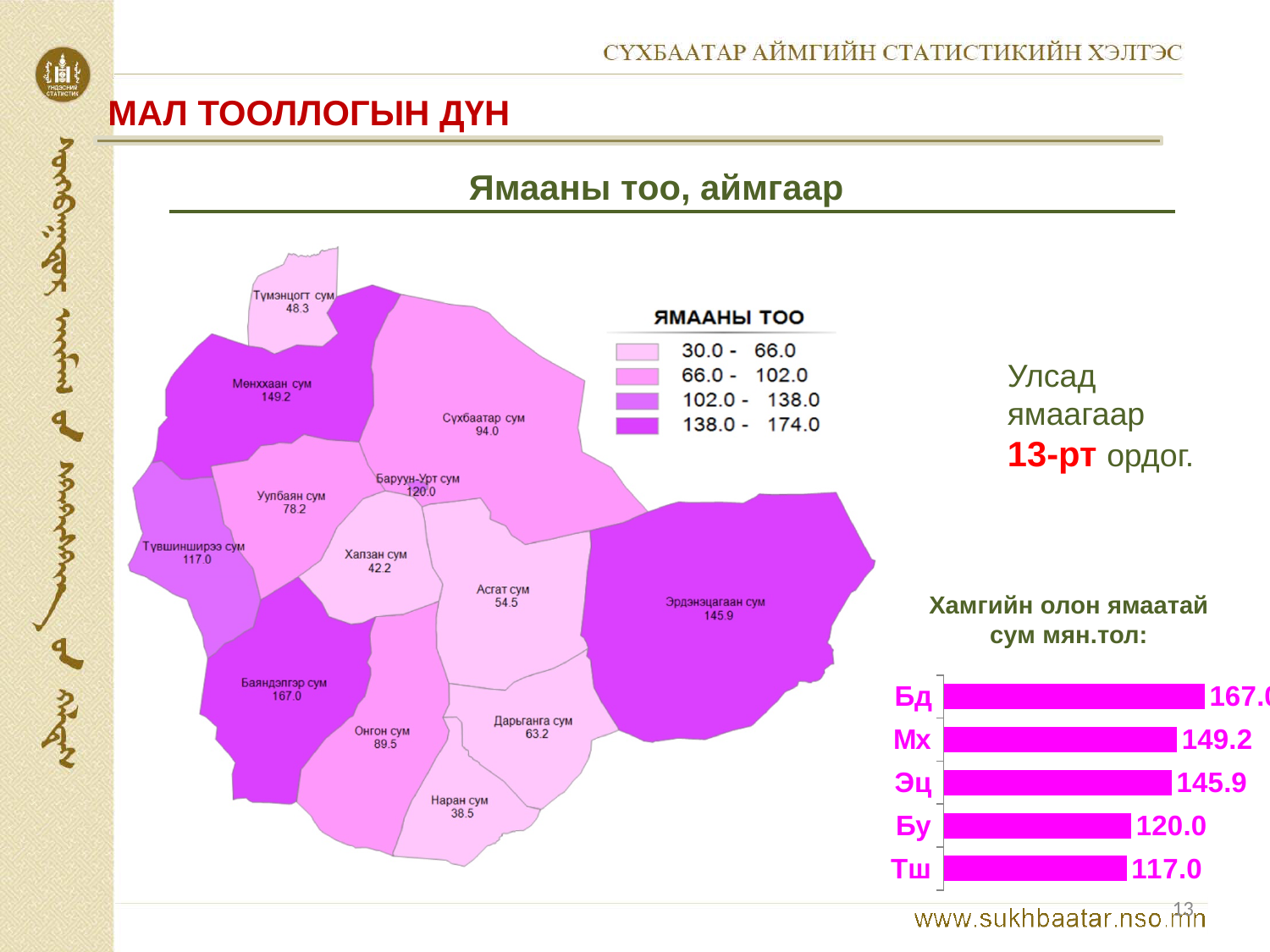
On the map titled "Ямааны тоо, аймгаар", what value is shown for Эрдэнэцагаан сум? 145.9 In the bar chart titled "Хамгийн олон ямаатай сум мян.тол:", what is the value for Эц? 145.9 In the bar chart titled "Хамгийн олон ямаатай сум мян.тол:", what is the difference between the values for Бу and Тш? 3.0 In the bar chart titled "Хамгийн олон ямаатай сум мян.тол:", what is the difference between the values for Бд and Тш? 50.0 In the bar chart titled "Хамгийн олон ямаатай сум мян.тол:", what is the value for Мх? 149.2 In the bar chart titled "Хамгийн олон ямаатай сум мян.тол:", which is larger, the value for Мх or the value for Эц? Мх In the bar chart titled "Хамгийн олон ямаатай сум мян.тол:", which category has the highest value? Бд In the bar chart titled "Хамгийн олон ямаатай сум мян.тол:", what is the value for Бд? 167.0 In the bar chart titled "Хамгийн олон ямаатай сум мян.тол:", which category has the lowest value? Тш What kind of chart is the one titled "Хамгийн олон ямаатай сум мян.тол:"? Bar chart In the bar chart titled "Хамгийн олон ямаатай сум мян.тол:", what is the value for Тш? 117.0 In the bar chart titled "Хамгийн олон ямаатай сум мян.тол:", how many categories are shown? 5